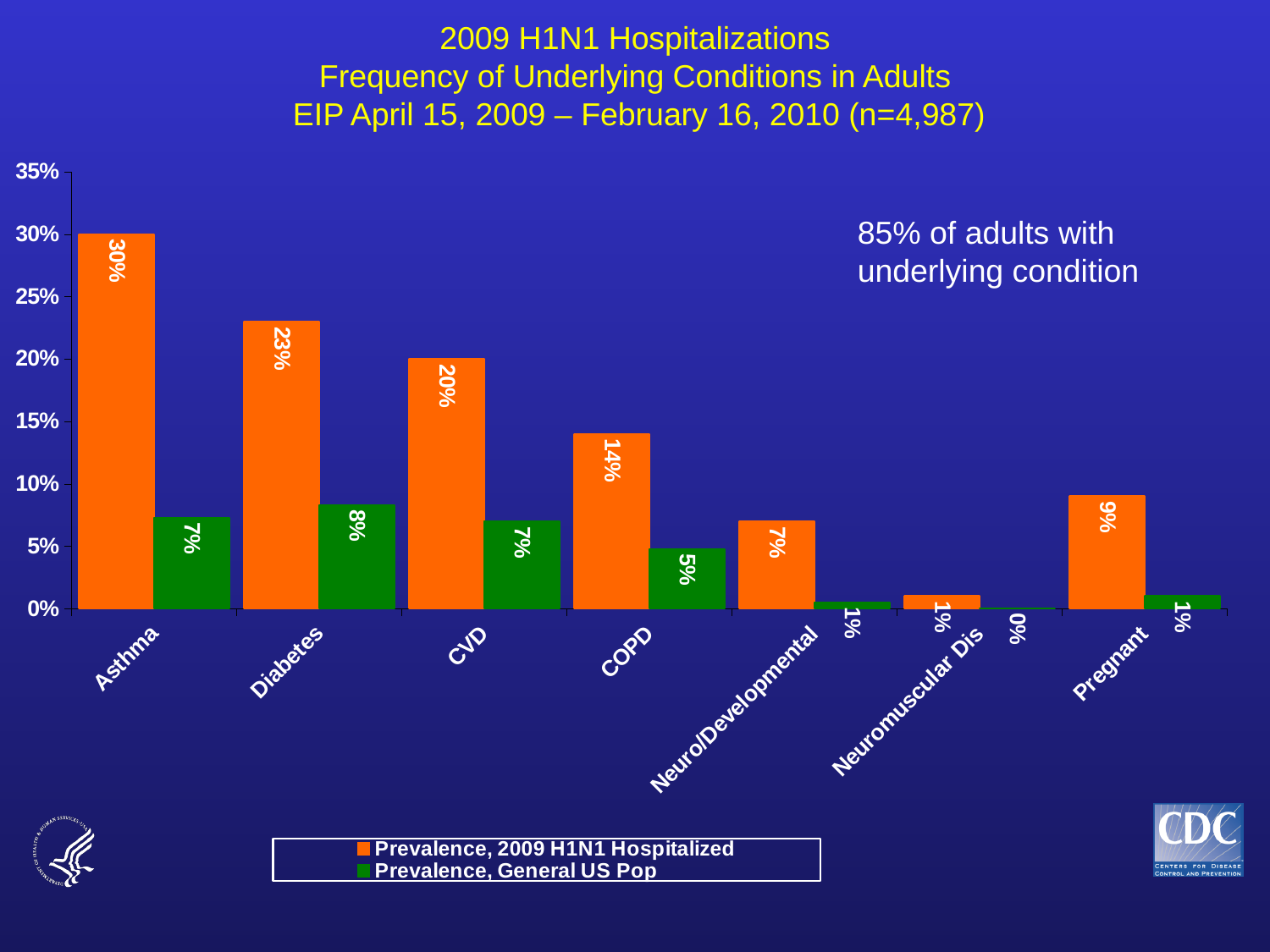
Which underlying condition has the highest prevalence among 2009 H1N1 hospitalized adults? Asthma What is the difference between the prevalence of CVD among 2009 H1N1 hospitalized adults and in the general US population? 13% What type of chart is shown on the slide? Bar chart Which colour represents the Prevalence, General US Pop series in the chart? Green What is the prevalence of diabetes in the general US population according to the chart? 8% How many series does the chart legend list? 2 How many underlying conditions are shown on the x axis of the chart? 7 Which is larger: the prevalence of diabetes among 2009 H1N1 hospitalized adults or the prevalence of CVD among 2009 H1N1 hospitalized adults? Diabetes What is the prevalence of COPD among 2009 H1N1 hospitalized adults? 14% Which underlying condition has the lowest prevalence among 2009 H1N1 hospitalized adults? Neuromuscular Dis What is the prevalence of asthma among 2009 H1N1 hospitalized adults? 30% What is the prevalence of pregnancy among 2009 H1N1 hospitalized adults? 9%